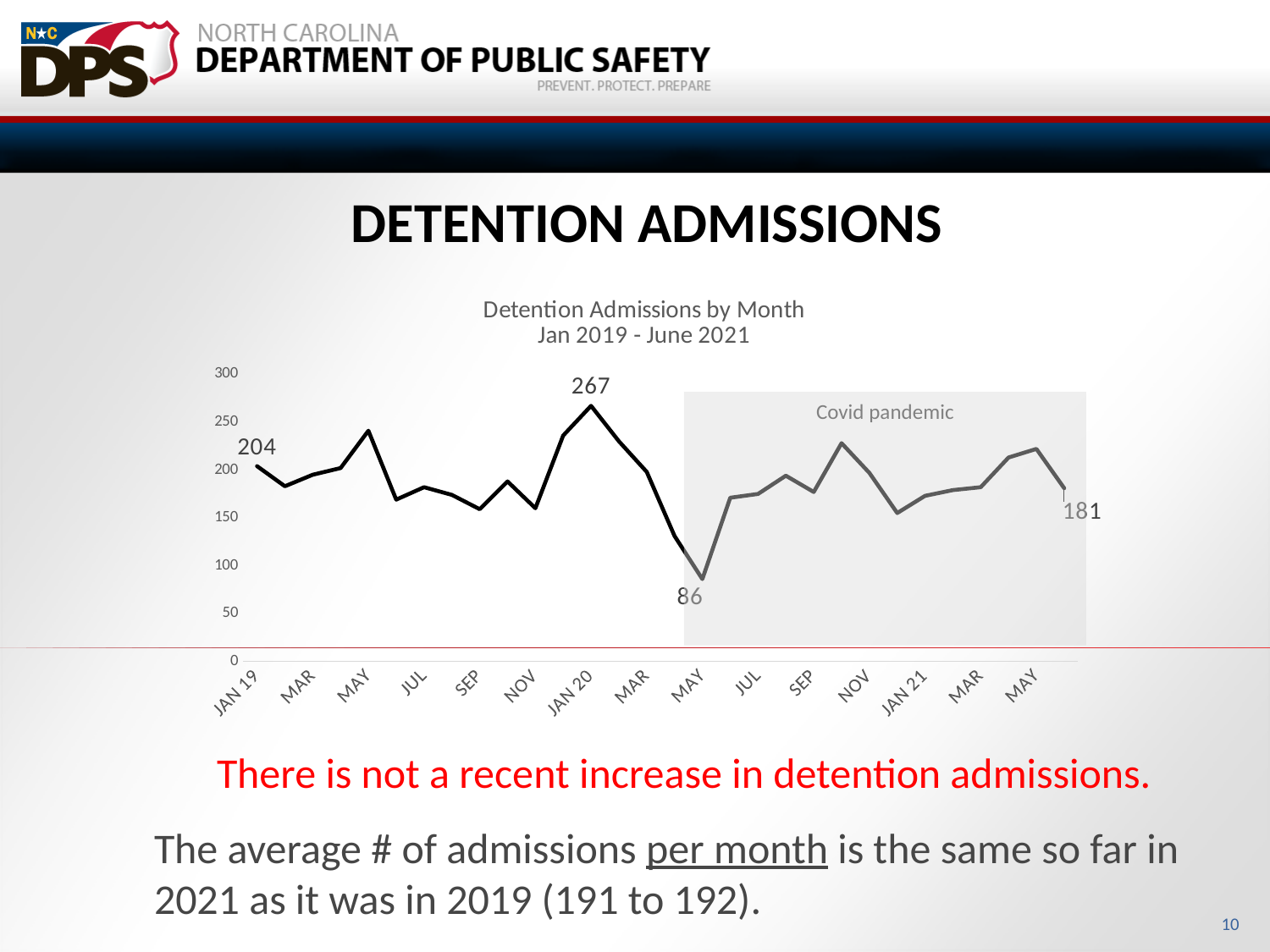
What is the value of detention admissions for JAN 19? 204 Is the value for SEP 19 greater or less than 200? less What label is shown in the shaded region of the chart? Covid pandemic What is the lowest value labeled on the chart? 86 What is the value of detention admissions for JAN 20? 267 What type of chart is shown on the slide? line chart What is the difference between the highest labeled value (267) and the lowest labeled value (86)? 181 Which is larger, the value for JAN 19 or the value for JAN 20? JAN 20 What is the title of the chart? Detention Admissions by Month Jan 2019 - June 2021 What is the difference between the JAN 19 value and the JAN 20 value? 63 What is the highest value labeled on the chart? 267 What is the value at the last point on the chart (June 2021)? 181